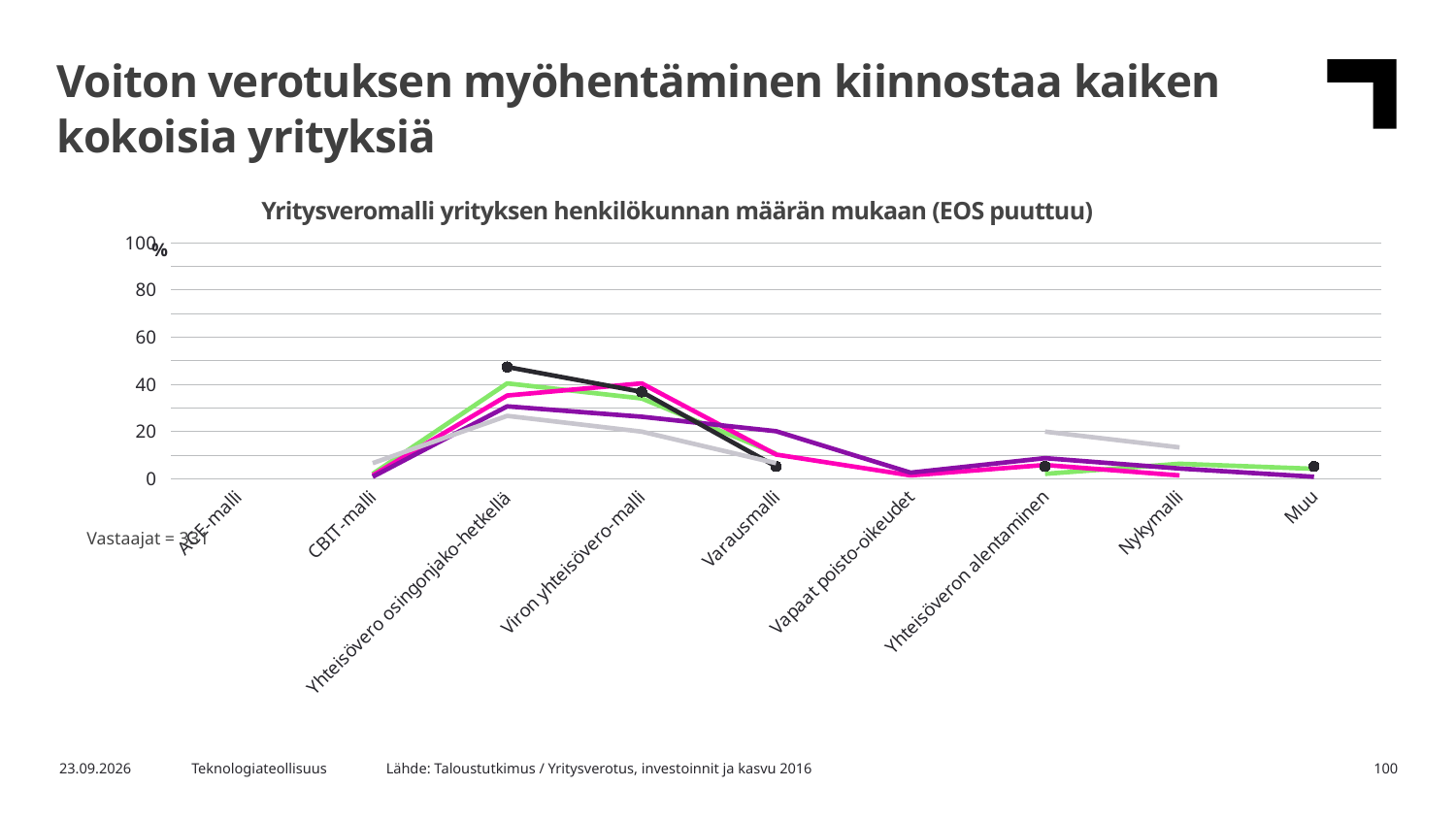
For which category does the magenta line reach its highest value? Viron yhteisövero-malli Is the value of the black line for Varausmalli greater or less than 20? less What is the highest value shown on the y axis of the chart? 100 What kind of chart is shown on the slide? Line chart What is the title of the chart? Yritysveromalli yrityksen henkilökunnan määrän mukaan (EOS puuttuu) Does the black line rise or fall between Viron yhteisövero-malli and Varausmalli? Fall For which category does the black line reach its highest value? Yhteisövero osingonjako-hetkellä Is the value of the grey line for Nykymalli greater or less than 20? less Is the value of the black line for Yhteisövero osingonjako-hetkellä greater or less than 40? greater How many categories are shown along the x axis of the chart? 9 At Yhteisövero osingonjako-hetkellä, which line is higher: the black line or the grey line? The black line